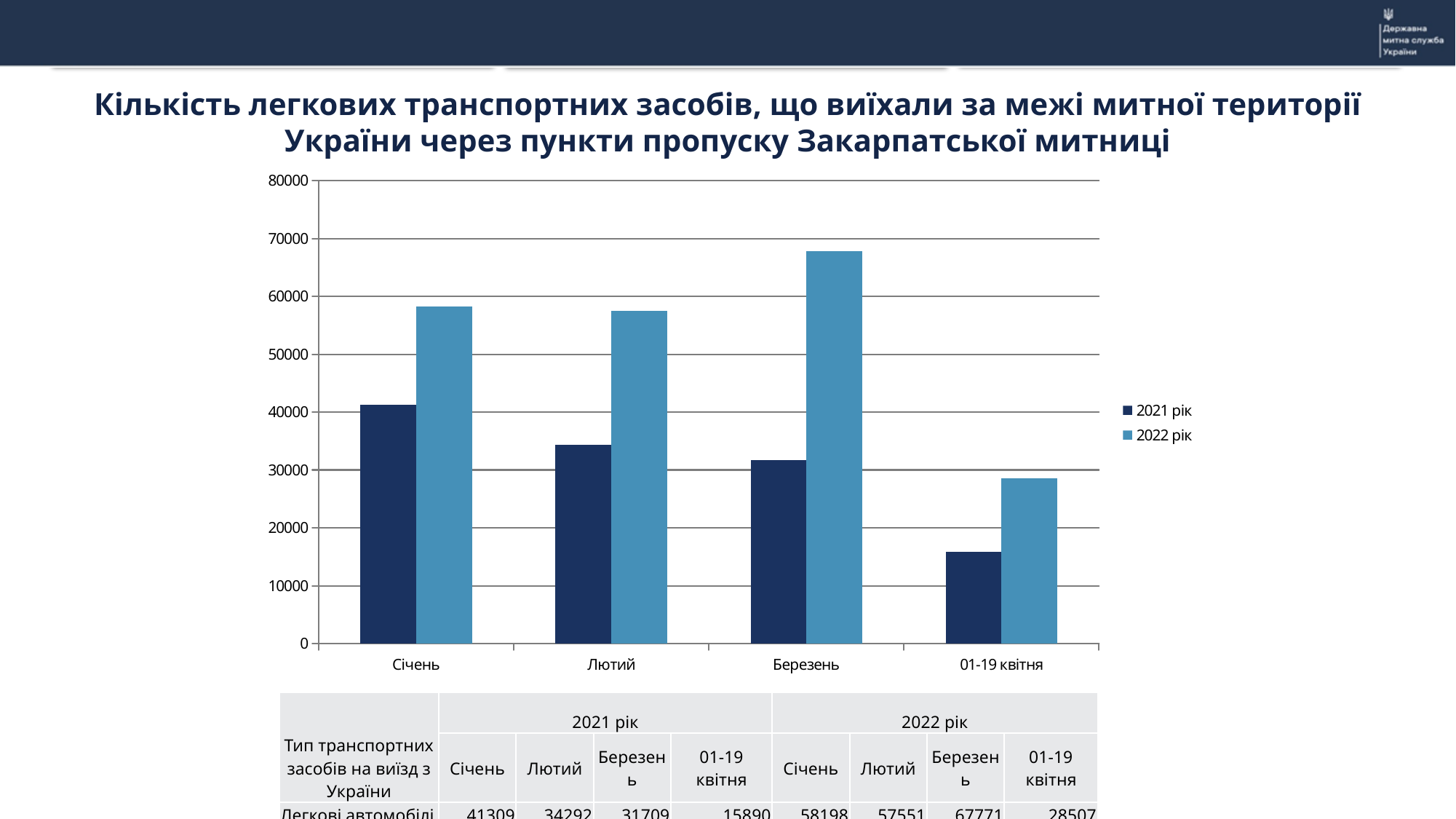
Which category has the highest value for the 2022 рік series? Березень How many series does the chart legend list? 2 Do the 2021 рік values rise or fall from Січень to 01-19 квітня? fall Which category has the lowest value for the 2021 рік series? 01-19 квітня For Січень, which series has the larger value, 2021 рік or 2022 рік? 2022 рік How many categories are shown on the x axis of the chart? 4 What kind of chart is shown on the slide? bar chart Is the 2021 рік value for Січень greater or less than 40000? greater What are the two entries in the chart legend? 2021 рік and 2022 рік Using the table values, what is the difference between the 2022 рік and 2021 рік values for Березень? 36062 According to the table on the slide, what is the 2022 рік value for Березень? 67771 Is the 2022 рік value for Лютий greater or less than 60000? less